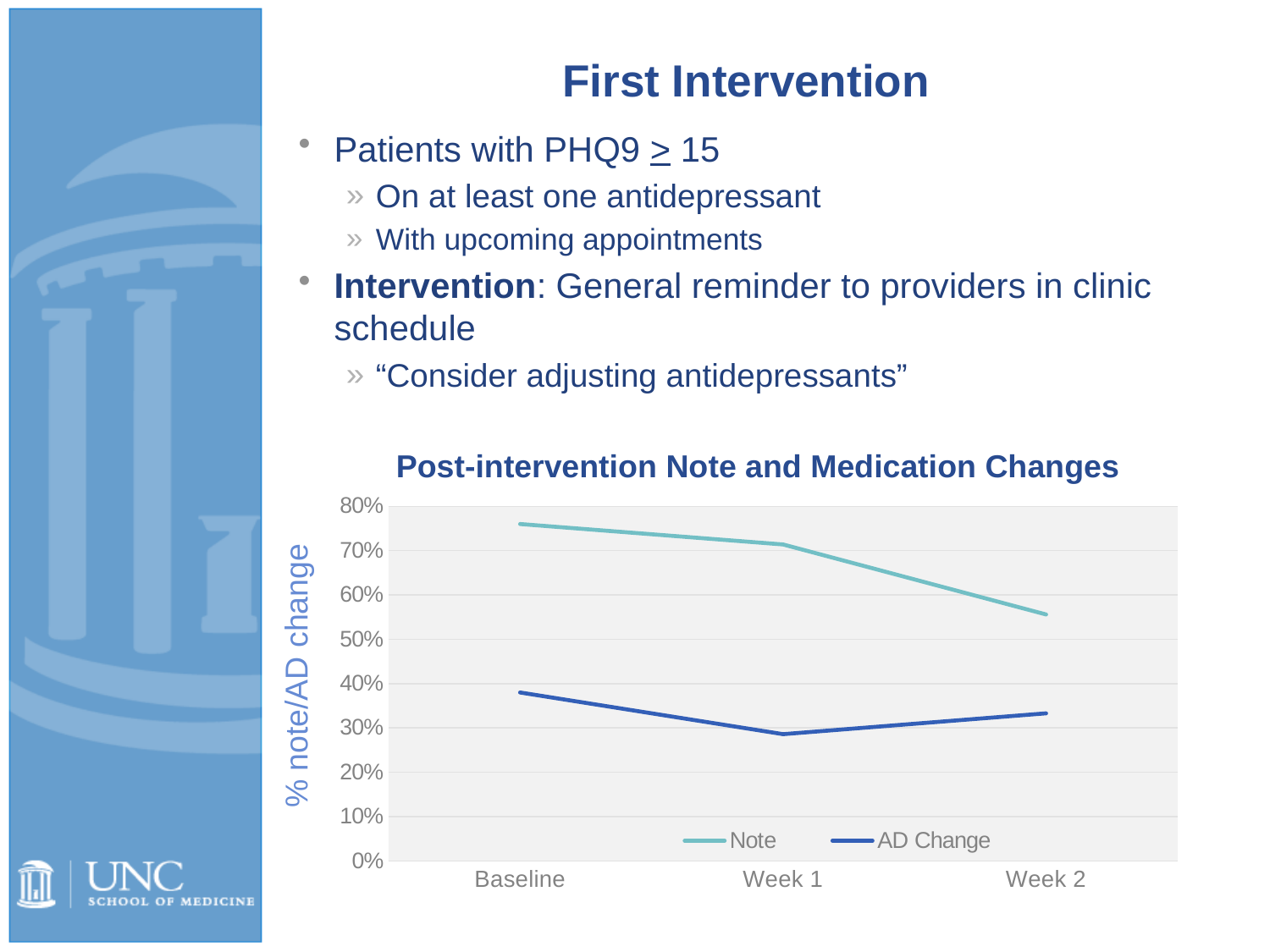
How many series does the legend of the chart list? 2 How many time points are shown on the x axis of the chart? 3 Does the Note series rise or fall from Baseline to Week 2? fall Is the value for Note at Week 2 greater or less than 60%? less At which time point is the Note series highest? Baseline Is the value for AD Change at Baseline greater or less than 30%? greater What is the label of the y axis of the chart? % note/AD change At which time point is the AD Change series lowest? Week 1 What are the two series named in the chart legend? Note and AD Change What kind of chart is shown under the title "Post-intervention Note and Medication Changes"? line chart At which time point is the Note series lowest? Week 2 Is the value for Note at Baseline greater or less than 70%? greater